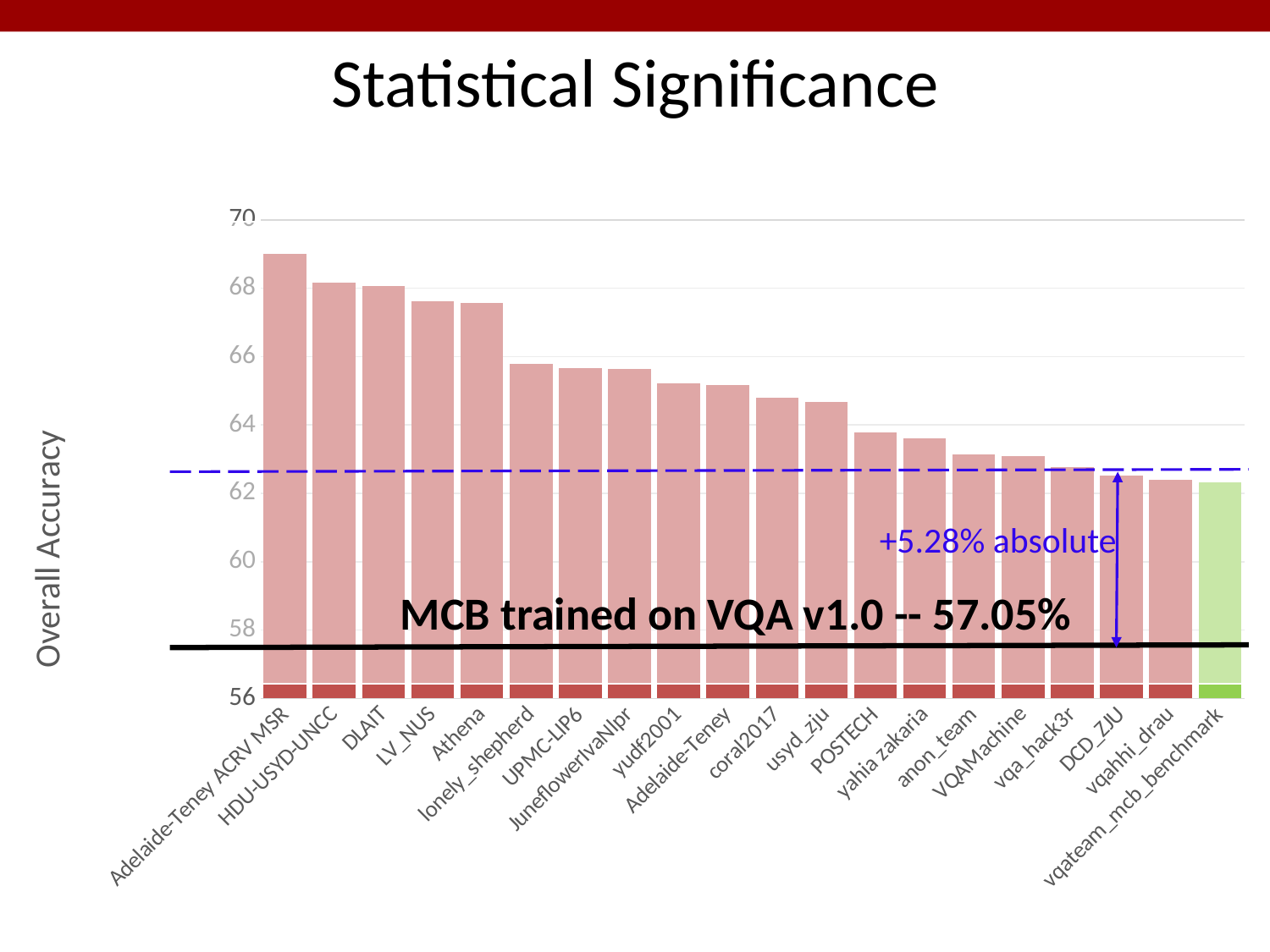
What type of chart is shown on the slide? bar chart Which team has the highest overall accuracy in the chart? Adelaide-Teney ACRV MSR What accuracy does the black horizontal reference line for MCB trained on VQA v1.0 represent? 57.05% Is the value for lonely_shepherd greater or less than 64? greater Is the value for LV_NUS greater or less than 68? less Do the bar values rise or fall from left to right along the x axis? fall Which has a higher overall accuracy, coral2017 or POSTECH? coral2017 Is the value for Adelaide-Teney ACRV MSR greater or less than 68? greater Which has a higher overall accuracy, Athena or lonely_shepherd? Athena How many bars (teams) are plotted in the chart? 20